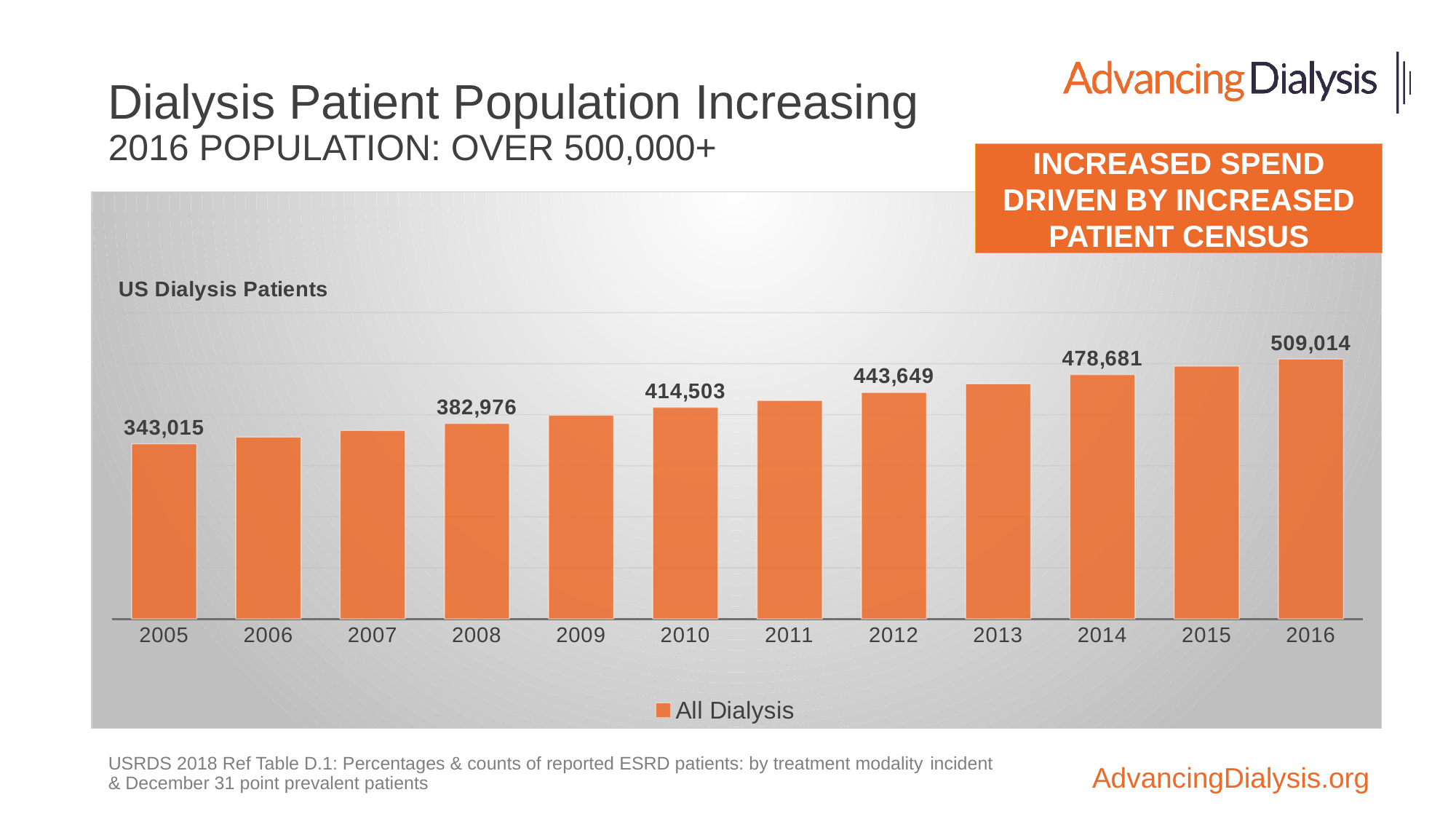
What kind of chart is shown on the slide? Bar chart What is the difference between the 2016 and 2005 values in the US Dialysis Patients chart? 165,999 What is the value for 2005 in the US Dialysis Patients chart? 343,015 What is the value for 2010 in the US Dialysis Patients chart? 414,503 What is the value for 2012 in the US Dialysis Patients chart? 443,649 What is the value for 2016 in the US Dialysis Patients chart? 509,014 Which year has the lowest number of US dialysis patients? 2005 Which is larger, the value for 2008 or the value for 2010? 2010 What is the difference between the 2014 and 2012 values in the US Dialysis Patients chart? 35,032 Do the values rise or fall from 2005 to 2016? Rise Which year has the highest number of US dialysis patients? 2016 How many years are shown on the x axis of the US Dialysis Patients chart? 12